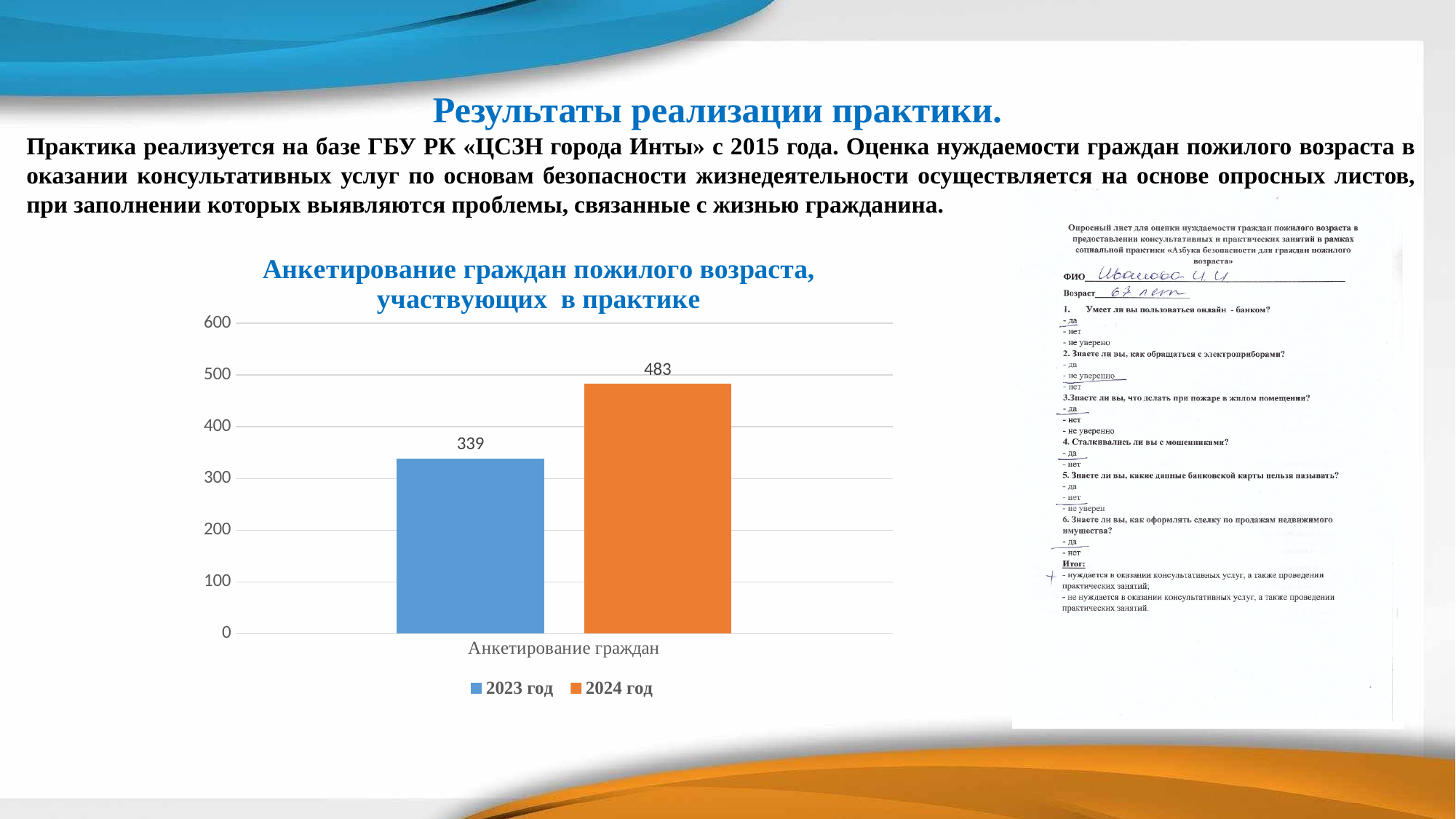
How many series does the legend list? 2 Which series has the higher value, 2023 год or 2024 год? 2024 год What is the difference between the 2024 год and 2023 год values? 144 What is the value for 2023 год in the chart? 339 How many categories are shown on the x axis of the chart? 1 What is the title of the chart? Анкетирование граждан пожилого возраста, участвующих в практике What kind of chart is shown on the slide? bar chart Is the value for 2024 год greater or less than 400? greater What is the value for 2024 год in the chart? 483 Which series has the lowest value in the chart? 2023 год What colour is the bar for 2024 год? orange Is the value for 2023 год greater or less than 400? less